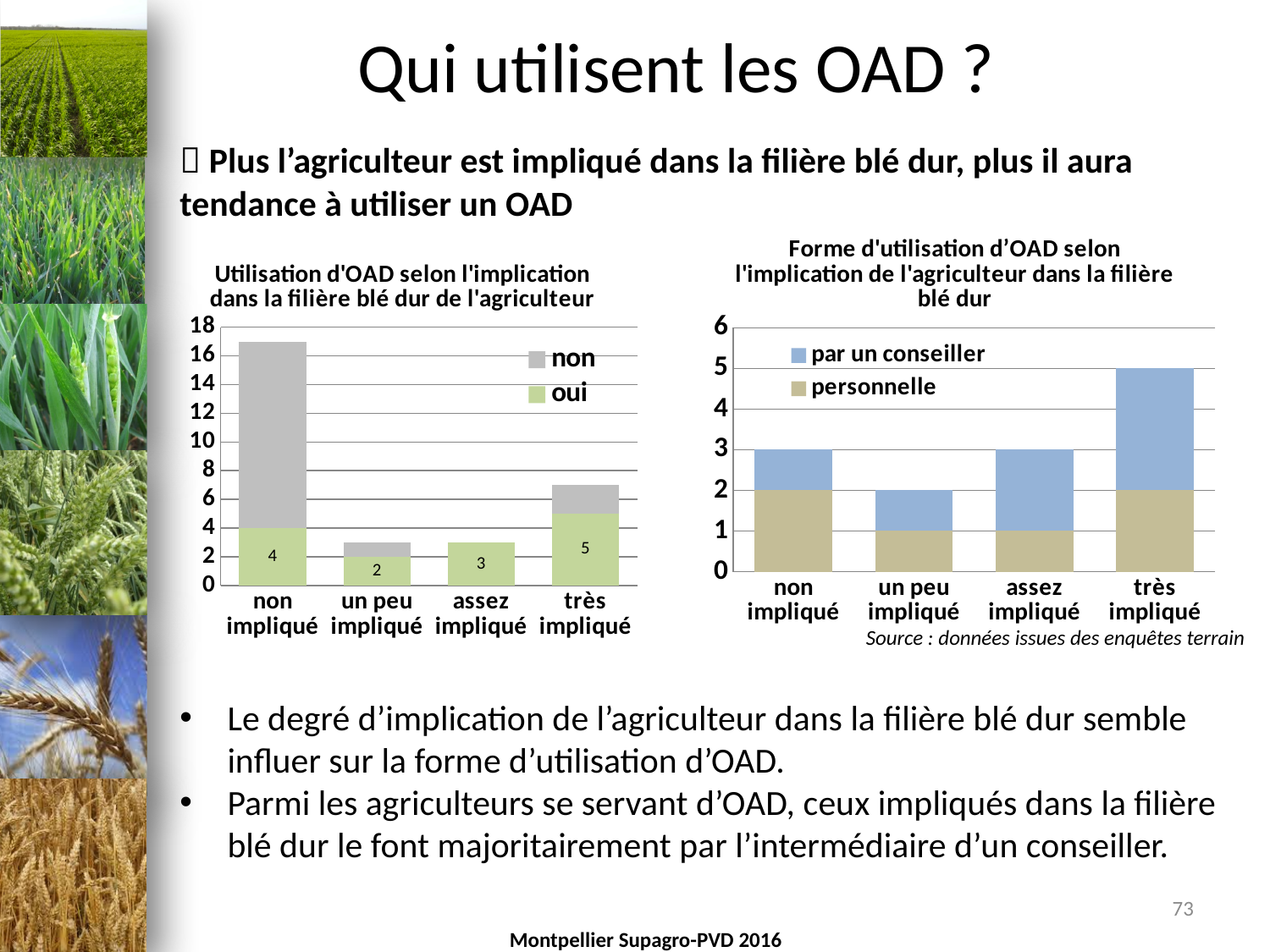
In the right chart 'Forme d'utilisation d'OAD selon l'implication de l'agriculteur dans la filière blé dur', which category has the lowest total bar? un peu impliqué In the right chart 'Forme d'utilisation d'OAD selon l'implication de l'agriculteur dans la filière blé dur', what is the 'personnelle' value for 'un peu impliqué'? 1 In the right chart 'Forme d'utilisation d'OAD selon l'implication de l'agriculteur dans la filière blé dur', what is the total of the stacked bar for 'très impliqué'? 5 In the left chart 'Utilisation d'OAD selon l'implication dans la filière blé dur de l'agriculteur', what is the 'oui' value for 'très impliqué'? 5 In the right chart 'Forme d'utilisation d'OAD selon l'implication de l'agriculteur dans la filière blé dur', how many categories are shown on the x axis? 4 In the left chart 'Utilisation d'OAD selon l'implication dans la filière blé dur de l'agriculteur', what is the difference between the 'oui' values for 'très impliqué' and 'assez impliqué'? 2 In the right chart 'Forme d'utilisation d'OAD selon l'implication de l'agriculteur dans la filière blé dur', which category has the highest total bar? très impliqué In the left chart 'Utilisation d'OAD selon l'implication dans la filière blé dur de l'agriculteur', what is the 'oui' value for 'non impliqué'? 4 In the left chart 'Utilisation d'OAD selon l'implication dans la filière blé dur de l'agriculteur', how many series does the legend list? 2 In the left chart 'Utilisation d'OAD selon l'implication dans la filière blé dur de l'agriculteur', is the total bar for 'non impliqué' greater or less than 10? greater What type of chart is the right chart 'Forme d'utilisation d'OAD selon l'implication de l'agriculteur dans la filière blé dur'? stacked bar chart In the left chart 'Utilisation d'OAD selon l'implication dans la filière blé dur de l'agriculteur', which category has the lowest 'oui' value? un peu impliqué